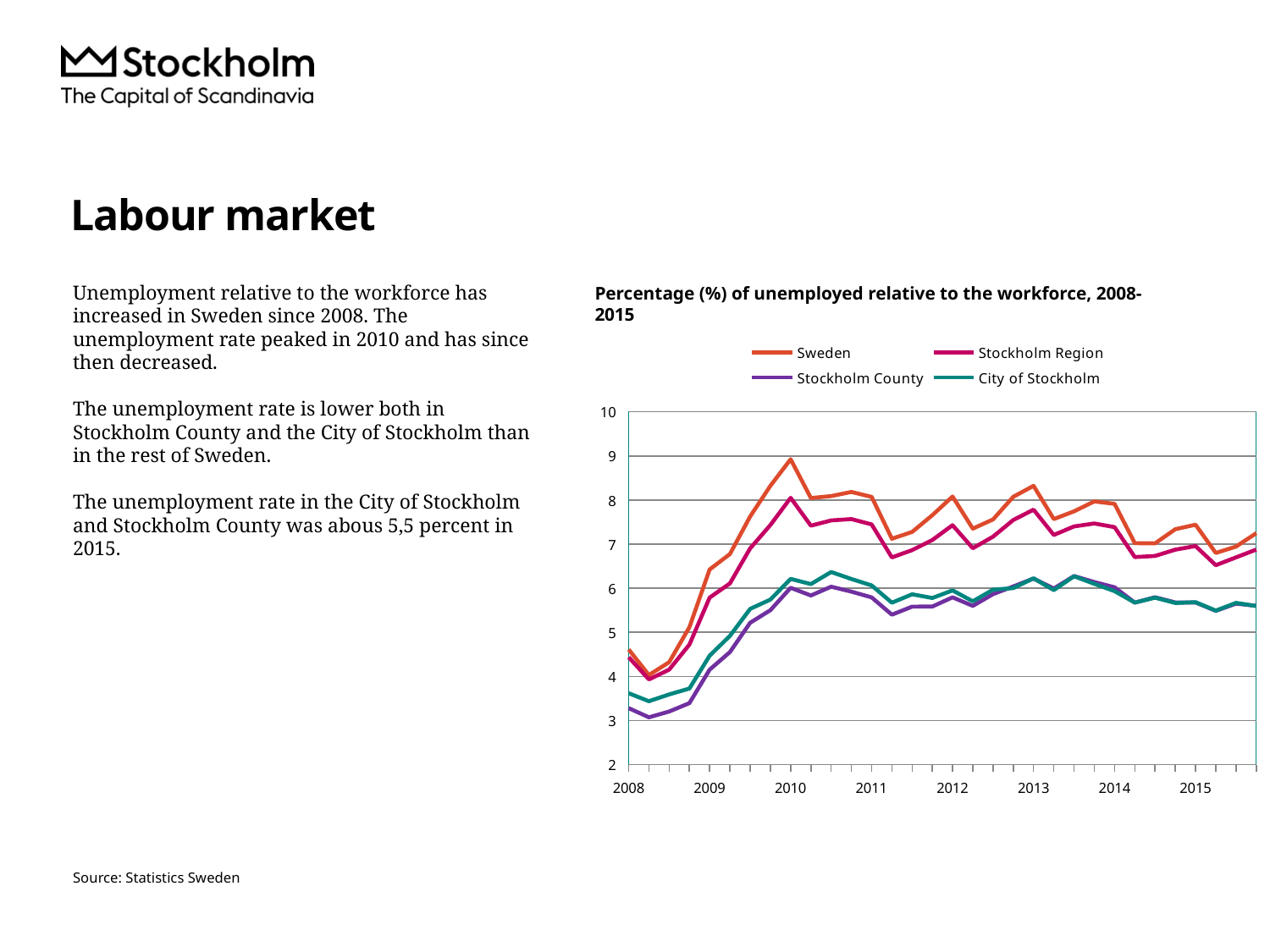
In 2010, which is larger: the value for Sweden or the value for City of Stockholm? Sweden Is the peak value for Sweden in 2010 greater or less than 8? greater What is the title of the chart? Percentage (%) of unemployed relative to the workforce, 2008-2015 Which series has the highest unemployment rate throughout the period shown? Sweden Is the value for City of Stockholm at the end of 2015 greater or less than 6? less Which series has the lowest value at the start of 2008? Stockholm County How many series does the chart's legend list? 4 Which series is drawn in orange in the chart? Sweden Is the value for Stockholm County at the start of 2008 greater or less than 4? less What kind of chart is shown on the slide? Line chart Does the unemployment rate for Sweden rise or fall between 2008 and 2010? rise